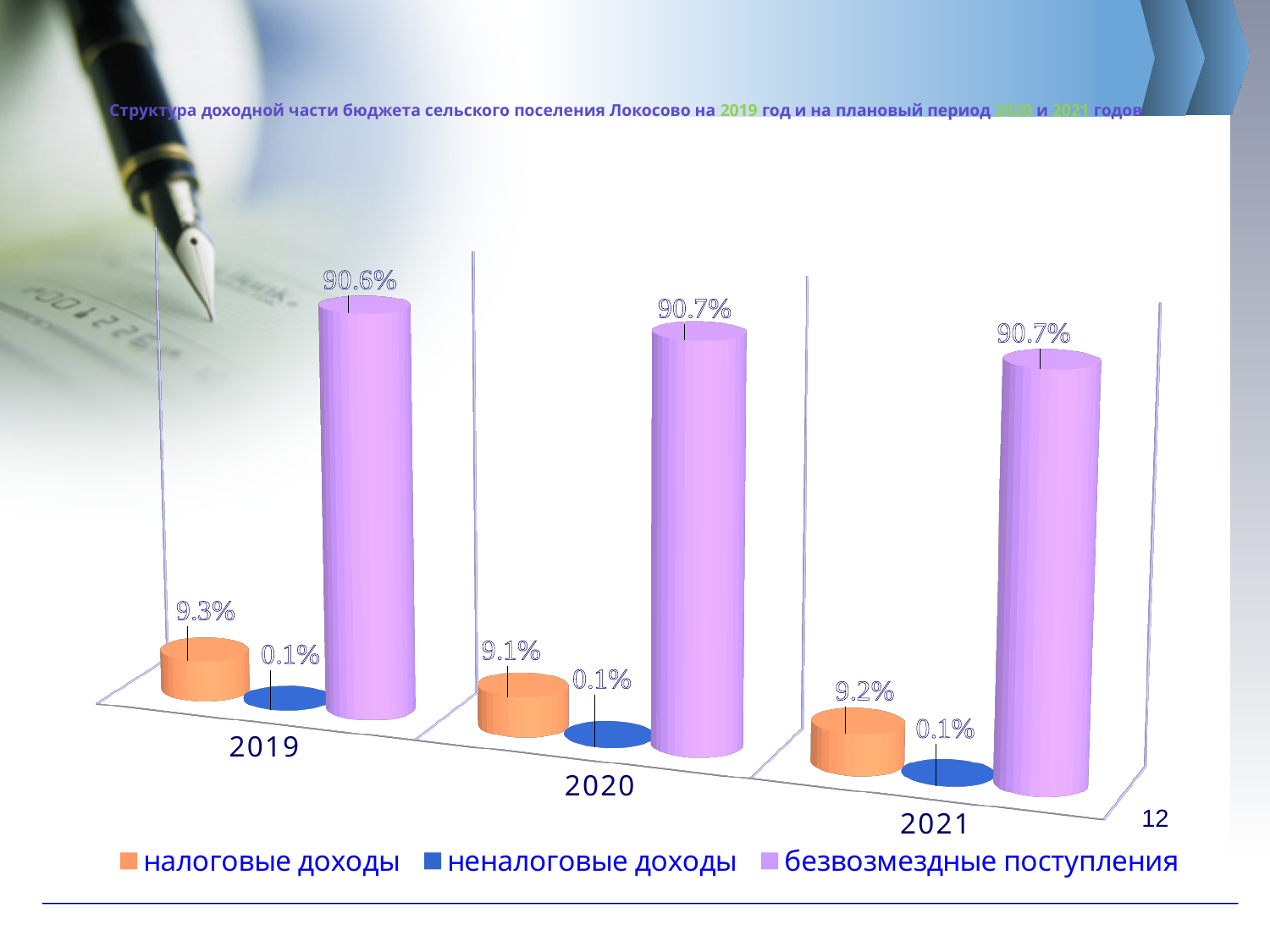
What is the value for налоговые доходы in 2021? 9.2% What is the value for безвозмездные поступления in 2019? 90.6% What colour are the bars for безвозмездные поступления? purple What is the value for налоговые доходы in 2020? 9.1% Which series has the highest value in 2020? безвозмездные поступления What kind of chart is shown on the slide? bar chart Which is larger: налоговые доходы in 2019 or налоговые доходы in 2021? налоговые доходы in 2019 What is the difference between налоговые доходы in 2019 and in 2020? 0.2% Which series has the lowest value in 2019? неналоговые доходы How many years are shown on the x axis? 3 How many series does the legend list? 3 What is the value for неналоговые доходы in 2021? 0.1%